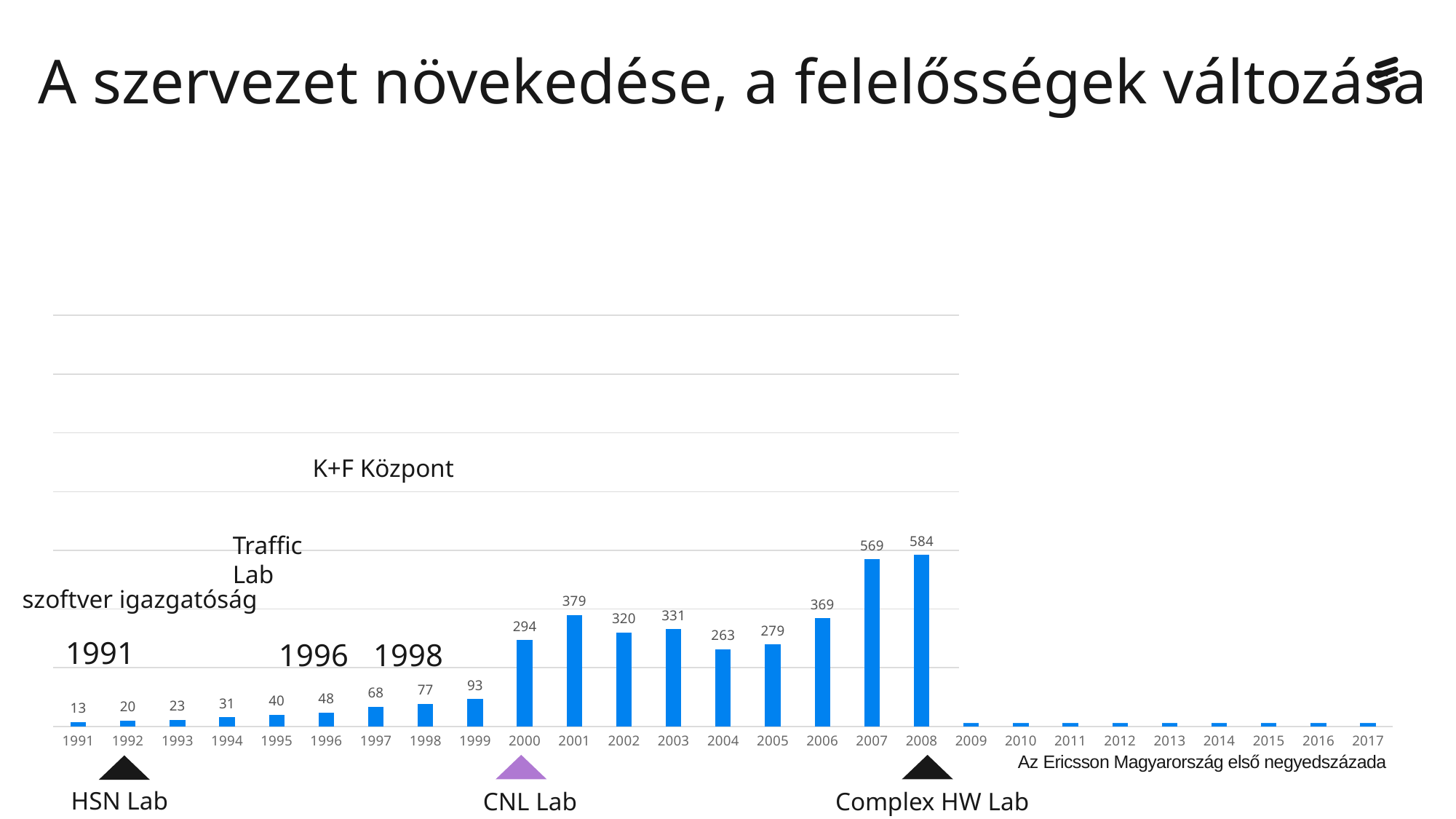
Which year has the highest value in the chart? 2008 What is the value shown for 2000? 294 How many years are shown on the x axis of the chart? 27 Do the values rise or fall from 1991 to 1999? rise What is the value shown for 2008? 584 What is the value shown for 1995? 40 What is the difference between the values for 2008 and 2007? 15 Which is larger, the value for 2004 or the value for 2006? 2006 Which lab is marked with a triangle under the year 2000? CNL Lab What is the difference between the values for 2001 and 2000? 85 Which is larger, the value for 2002 or the value for 2003? 2003 What kind of chart is shown on the slide? bar chart